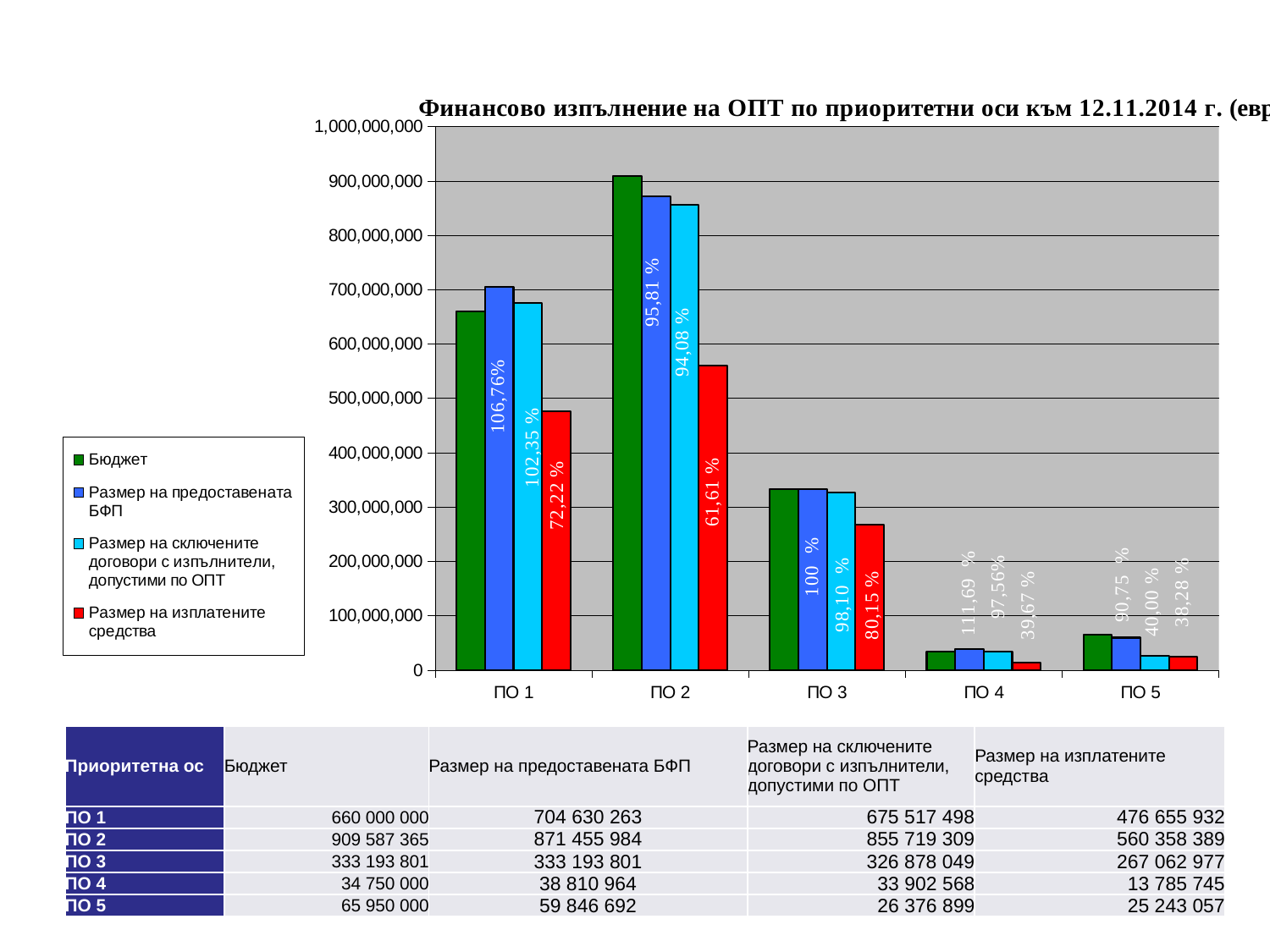
Which priority axis has the highest Бюджет? ПО 2 What is the difference between the Бюджет and the Размер на изплатените средства for ПО 1? 183 344 068 Is the Бюджет bar for ПО 2 greater or less than 900,000,000? greater Which priority axis has the lowest Бюджет? ПО 4 Which has the larger Бюджет, ПО 1 or ПО 3? ПО 1 What kind of chart is shown on the slide? bar chart What is the Бюджет value for ПО 2? 909 587 365 What is the value of Размер на изплатените средства for ПО 1? 476 655 932 How many priority axes (categories) are shown on the x axis of the chart? 5 What percentage label is printed on the Размер на изплатените средства bar for ПО 2? 61,61 % How many series does the chart legend list? 4 What colour represents the Бюджет series in the chart? green